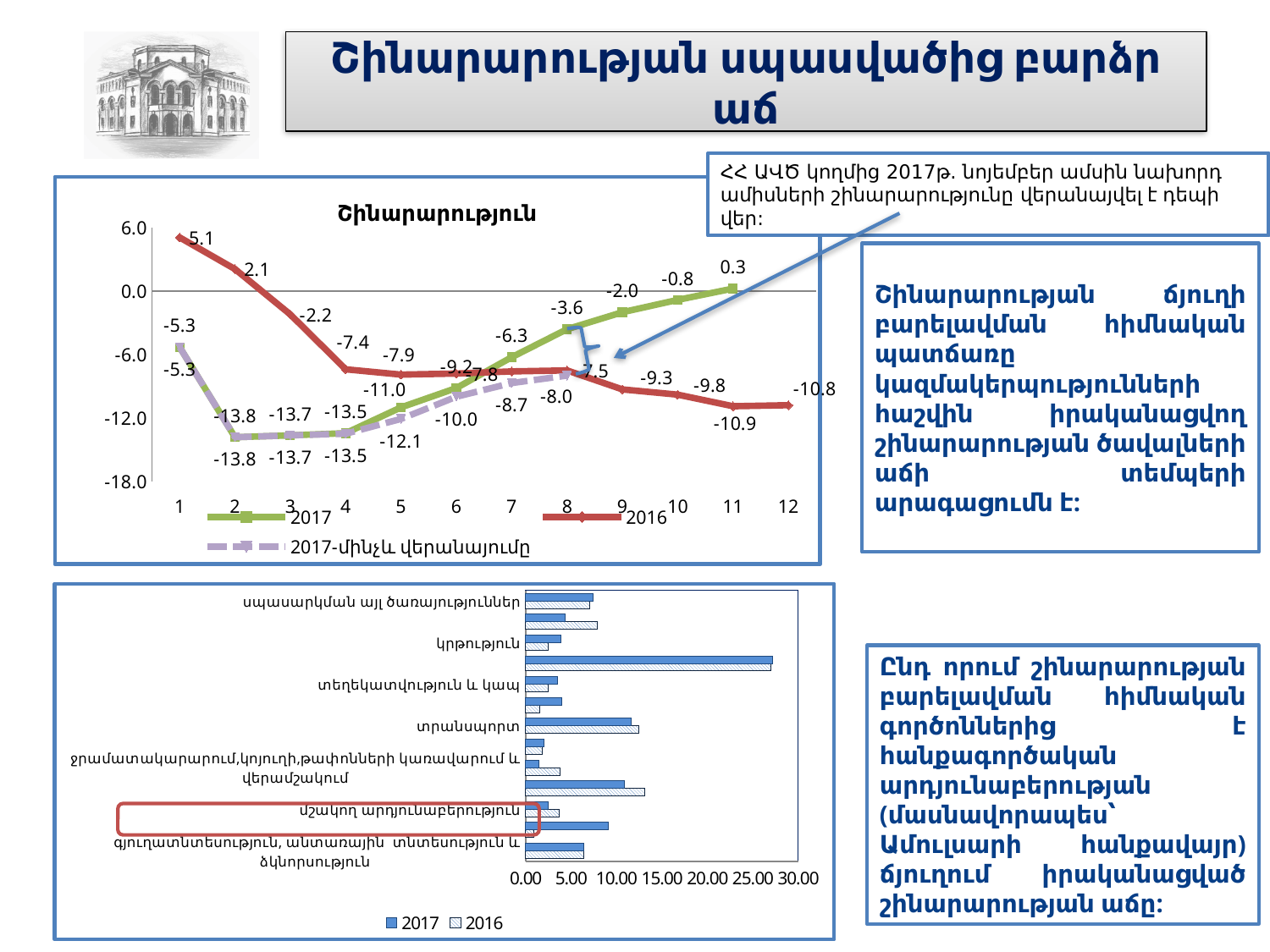
In the line chart titled Շինարարություն, at which point does the 2016 series reach its lowest value? 11 In the line chart titled Շինարարություն, what is the value of the 2016 series at point 12? -10.8 In the line chart titled Շինարարություն, at which point does the 2016 series reach its highest value? 1 What kind of chart is the lower chart on the slide? bar chart In the line chart titled Շինարարություն, does the 2017 series rise or fall from point 5 to point 11? rise In the line chart titled Շինարարություն, what is the value of the 2017 series at point 11? 0.3 In the line chart titled Շինարարություն, what is the value of the 2017 series at point 9? -2.0 In the line chart titled Շինարարություն, what is the difference between the 2016 values at point 1 and point 2? 3.0 In the line chart titled Շինարարություն, what is the value of the 2016 series at point 1? 5.1 In the lower bar chart, is the 2017 value for կրթություն greater or less than 25.00? less In the line chart titled Շինարարություն, which series has the larger value at point 11, 2017 or 2016? 2017 How many series does the legend of the line chart titled Շինարարություն list? 3